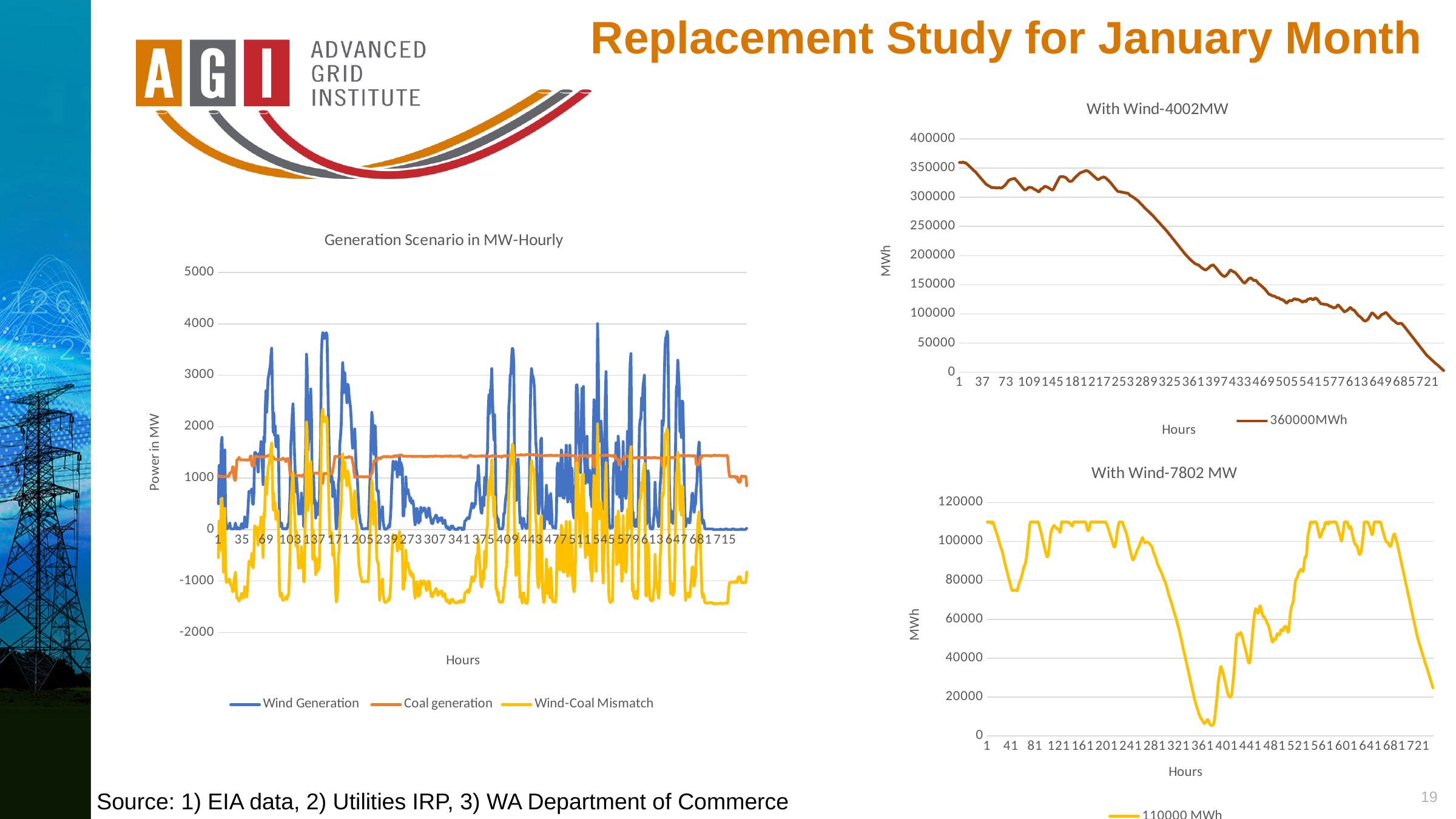
In the "With Wind-7802 MW" chart, is the value at hour 1 greater or less than 100000? greater How many series does the legend of the "Generation Scenario in MW-Hourly" chart list? 3 In the "With Wind-7802 MW" chart, is the value at hour 361 greater or less than 20000? less In the "Generation Scenario in MW-Hourly" chart, which series is shown in blue? Wind Generation What is the y-axis title of the "Generation Scenario in MW-Hourly" chart? Power in MW What kind of chart is the "Generation Scenario in MW-Hourly" chart? line chart In the "Generation Scenario in MW-Hourly" chart, is the Coal generation value at hour 341 greater or less than 1000? greater How many series does the legend of the "With Wind-4002MW" chart list? 1 In the "With Wind-4002MW" chart, do the values generally rise or fall as the hours increase? fall What kind of chart is the "With Wind-4002MW" chart? line chart